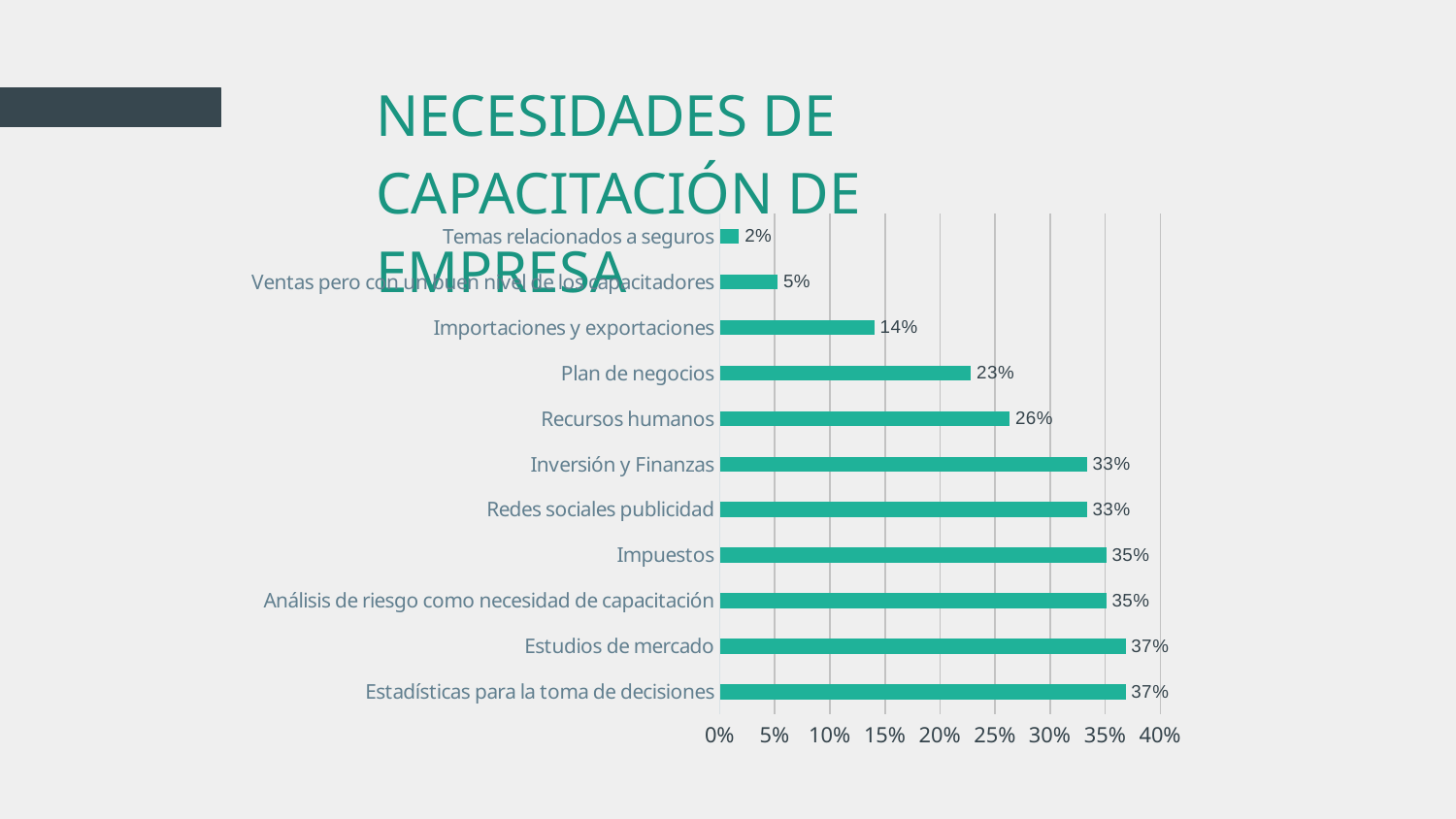
What is the value for Impuestos? 35% What is the highest value shown in the chart? 37% Which is larger, the value for Inversión y Finanzas or the value for Plan de negocios? Inversión y Finanzas What is the value for Recursos humanos? 26% What is the title of the slide? NECESIDADES DE CAPACITACIÓN DE EMPRESA What is the value for Importaciones y exportaciones? 14% What is the value for Plan de negocios? 23% What is the difference between the values for Impuestos and Importaciones y exportaciones? 21% How many categories are shown in the chart? 11 What type of chart is shown on the slide? Bar chart Which category has the lowest value? Temas relacionados a seguros What is the difference between the values for Estudios de mercado and Recursos humanos? 11%